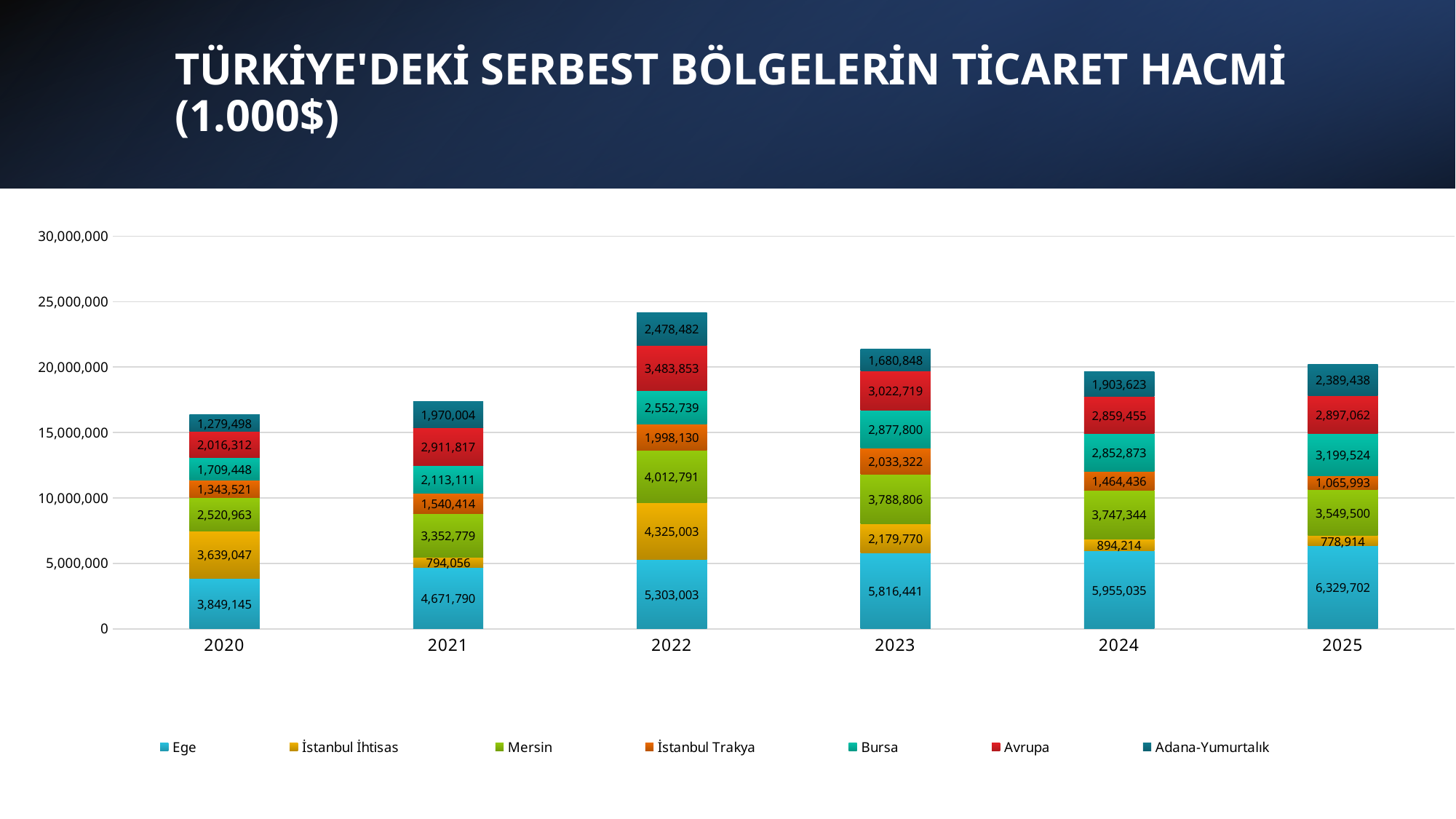
Which is larger, Mersin in 2022 or Mersin in 2023? Mersin in 2022 How many series does the legend list? 7 What is the value for Avrupa in 2021? 2,911,817 What is the value for Adana-Yumurtalık in 2025? 2,389,438 What is the difference between the Ege value in 2025 and in 2020? 2,480,557 In which year is the İstanbul İhtisas value lowest? 2025 In which year is the Ege value highest? 2025 How many years are shown on the x axis? 6 What is the value for Ege in 2022? 5,303,003 Which year has the tallest stacked bar overall? 2022 What is the total of the stacked bar for 2020? 16,357,934 What type of chart is shown on the slide? Stacked bar chart